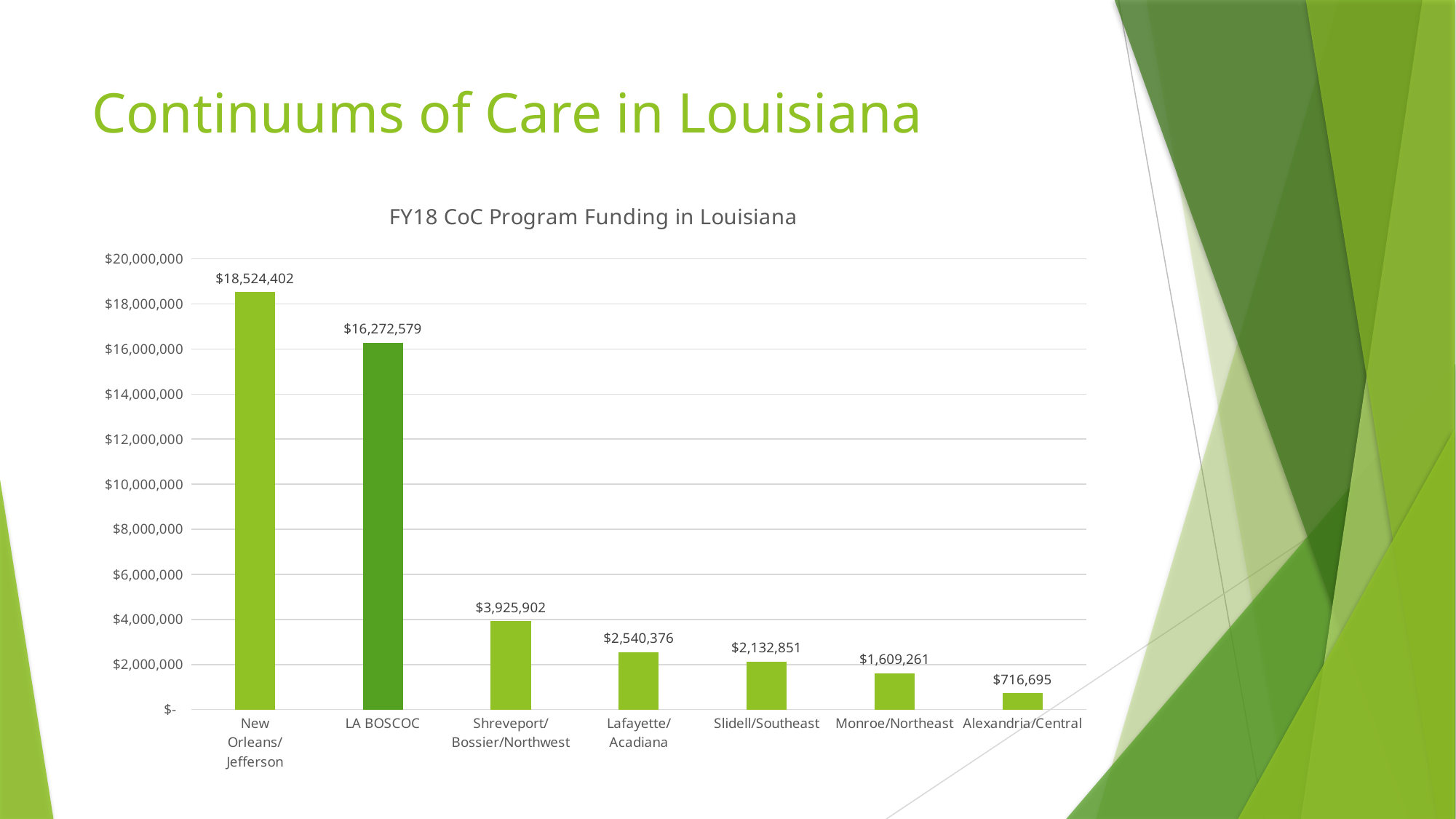
Do the funding values rise or fall moving from left to right across the chart? Fall What is the difference in funding between Slidell/Southeast and Monroe/Northeast? $523,590 How many continuums of care are shown in the chart? 7 What is the funding value shown for Alexandria/Central? $716,695 What is the FY18 CoC program funding for New Orleans/Jefferson? $18,524,402 What type of chart is used to show FY18 CoC Program Funding in Louisiana? Bar chart What is the funding value shown for Shreveport/Bossier/Northwest? $3,925,902 What is the FY18 CoC program funding for LA BOSCOC? $16,272,579 How much more funding did New Orleans/Jefferson receive than LA BOSCOC? $2,251,823 Which continuum of care received the highest FY18 CoC program funding? New Orleans/Jefferson Which received more funding, Lafayette/Acadiana or Slidell/Southeast? Lafayette/Acadiana Which continuum of care received the lowest FY18 CoC program funding? Alexandria/Central